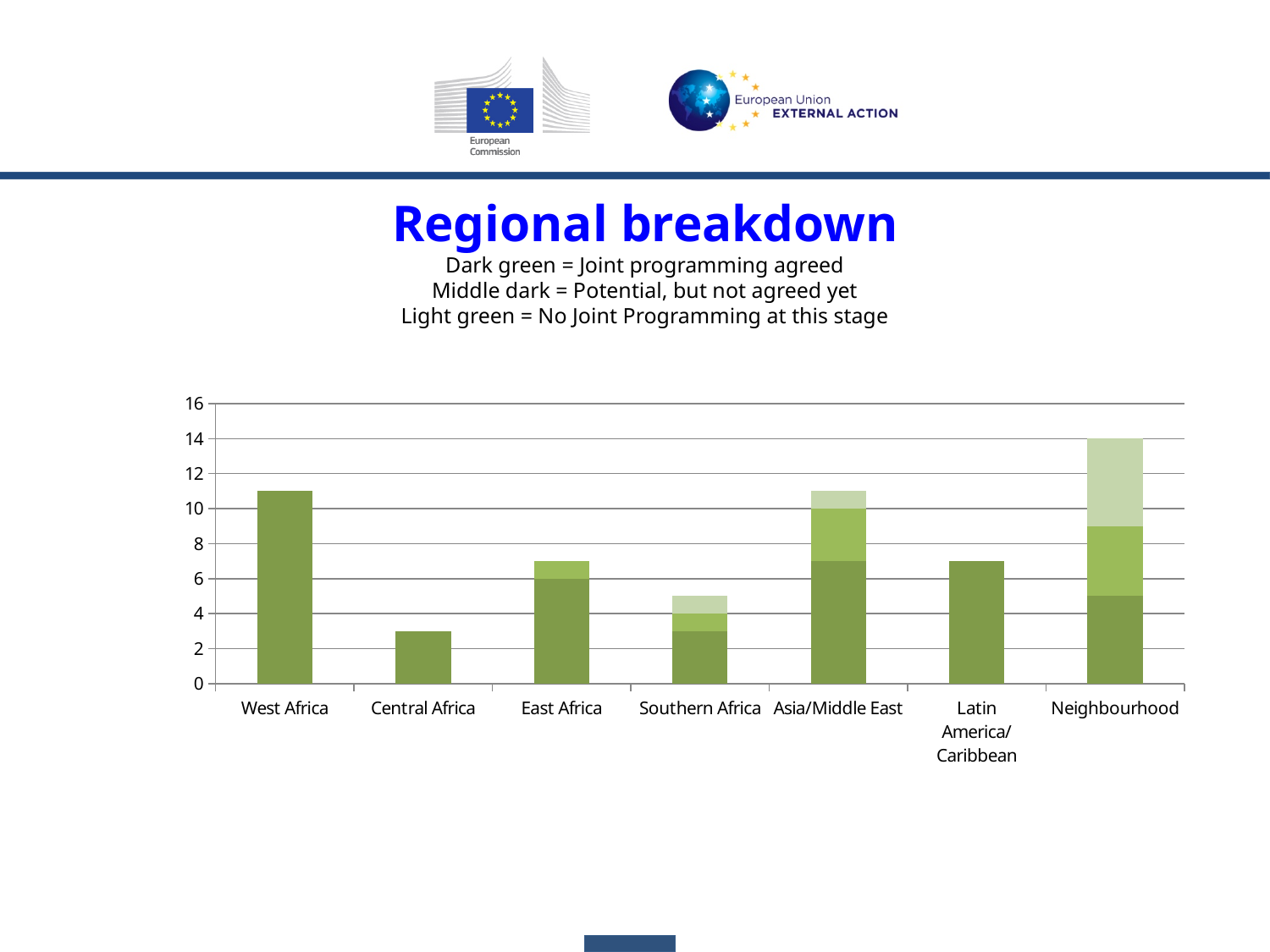
What is the total height of the stacked bar for Neighbourhood? 14 According to the slide text, what does the dark green colour in the chart represent? Joint programming agreed How many regions are shown on the x axis of the chart? 7 Which region has the tallest stacked bar in the chart? Neighbourhood Which has the taller bar, Asia/Middle East or Latin America/Caribbean? Asia/Middle East Is the total value for West Africa greater or less than 10? greater What is the title of the chart on the slide? Regional breakdown Is the value for Central Africa greater or less than 4? less What is the value of the dark green (Joint programming agreed) segment for East Africa? 6 Is the value for Latin America/Caribbean greater or less than 6? greater Which region has the shortest bar in the chart? Central Africa What kind of chart is shown on the slide? bar chart